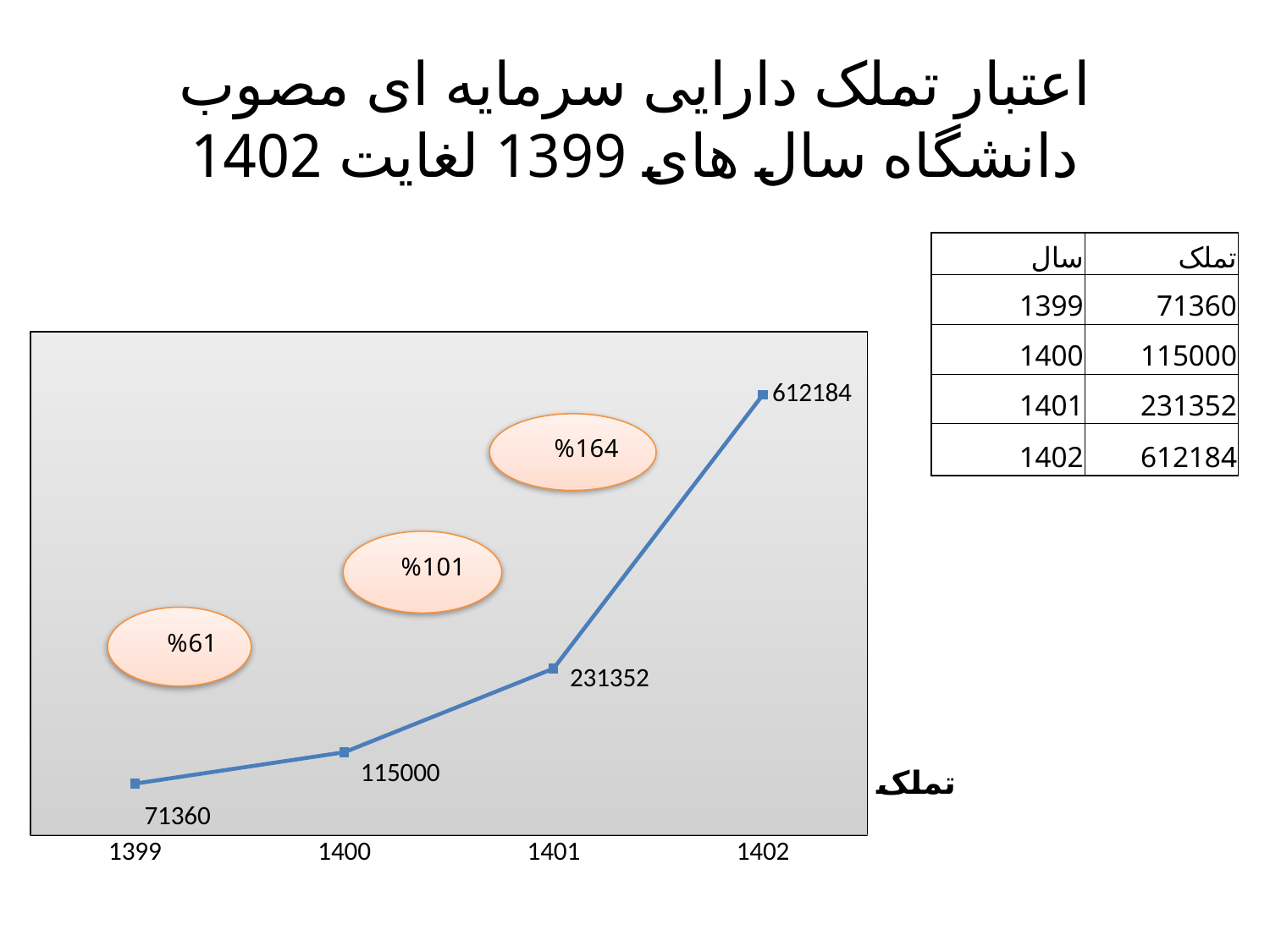
What is the value for 1400? 115000 What is the difference between the values for 1402 and 1401? 380832 What is the value for 1402? 612184 Which year has the highest value? 1402 How many years are plotted on the x axis? 4 What kind of chart is shown? line chart Which year has the lowest value? 1399 Which is larger, the value for 1401 or the value for 1400? 1401 What is the difference between the values for 1400 and 1399? 43640 What is the value for 1401? 231352 Do the values rise or fall from 1399 to 1402? rise What is the value for 1399? 71360